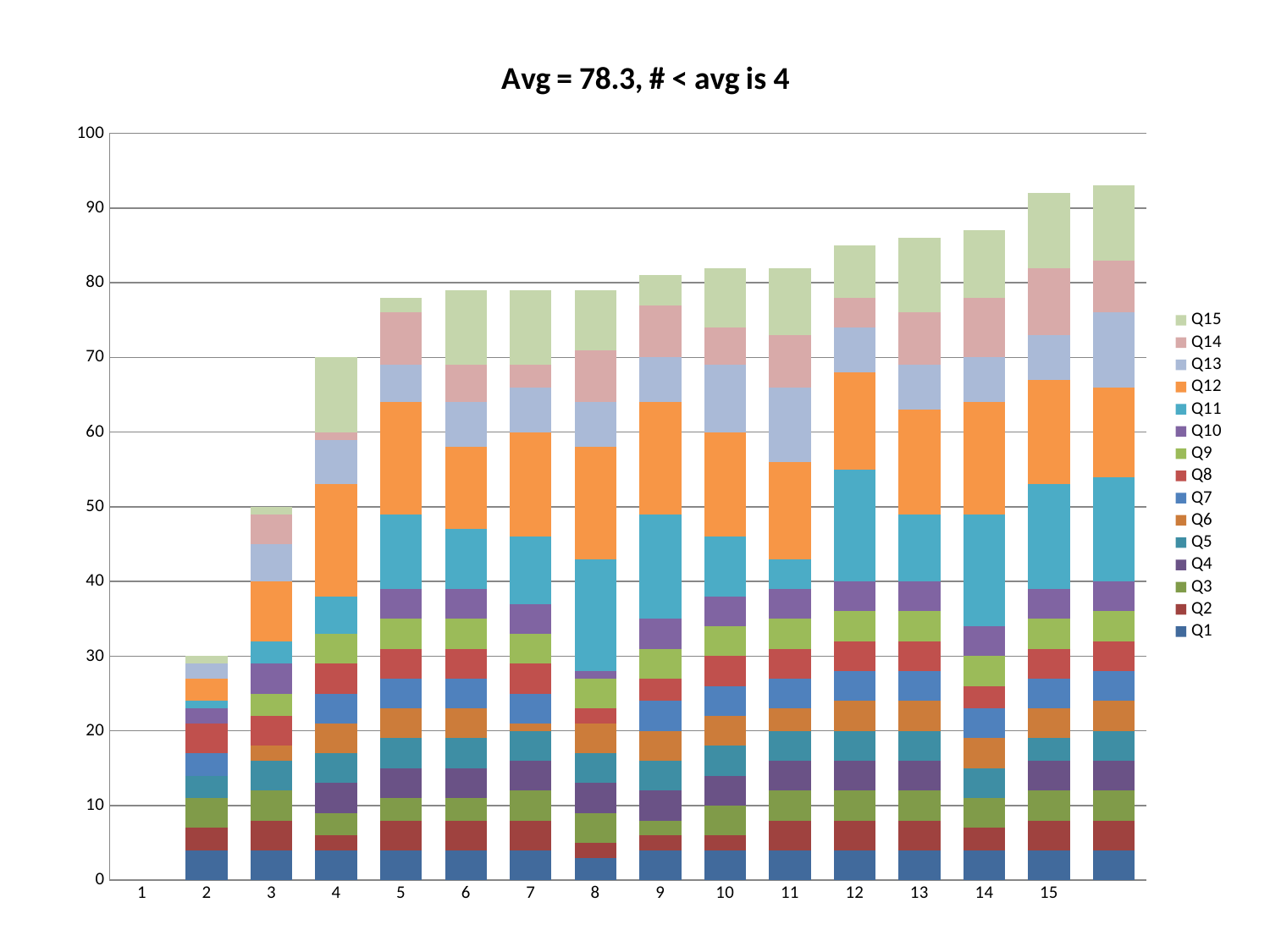
Which has the larger total, category 2 or category 3? Category 3 What is the title of the chart? Avg = 78.3, # < avg is 4 Which has the larger total, category 5 or category 15? Category 15 Is the total for category 8 greater or less than 80? less How many series does the legend list? 15 What kind of chart is shown on the slide? Stacked bar chart Do the bar totals generally rise or fall from left to right along the x axis? Rise Is the total for category 12 greater or less than 80? greater Is the total for category 15 greater or less than 90? greater Which series is listed at the bottom of the legend? Q1